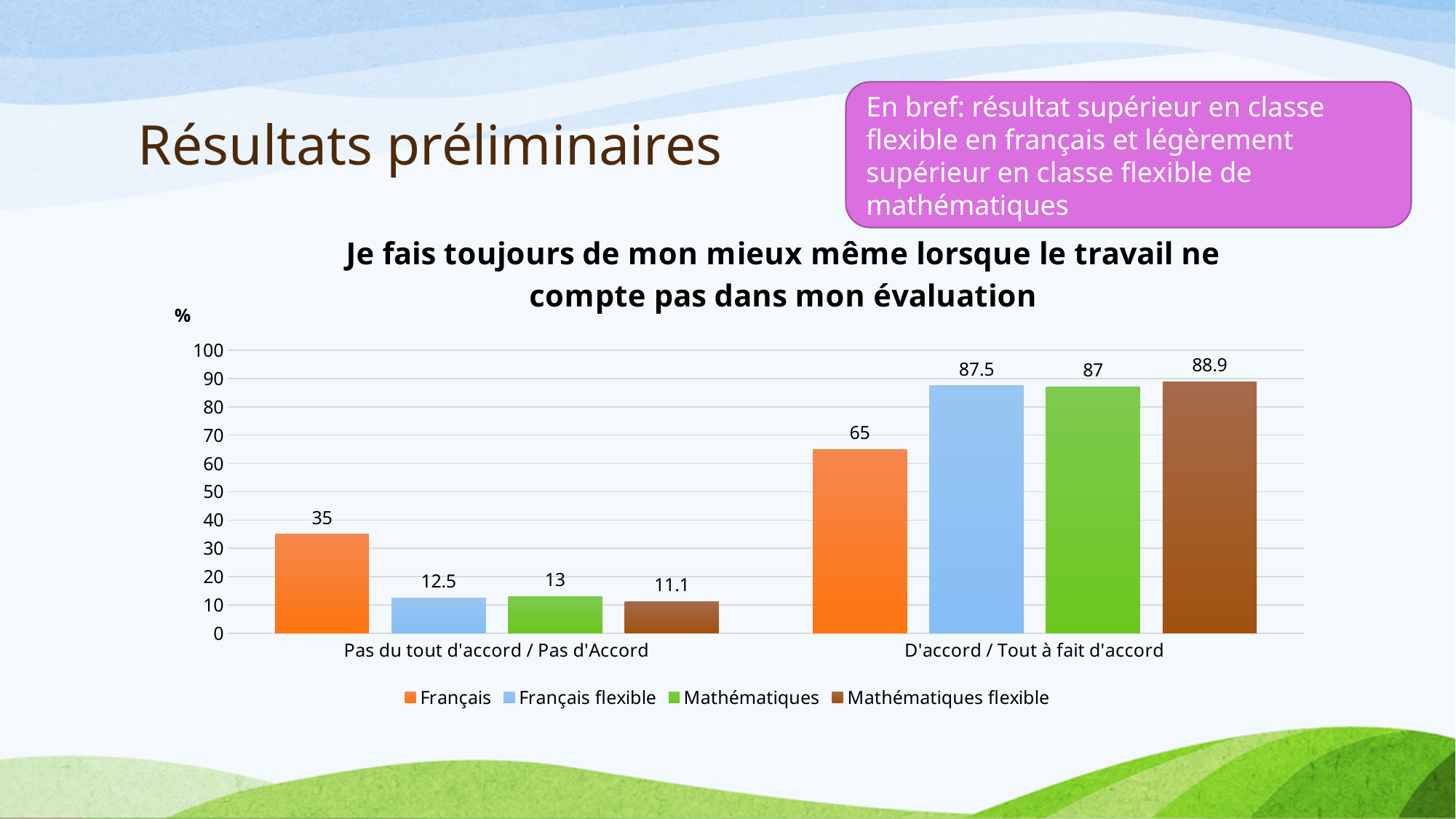
What is the value for Mathématiques flexible in the 'D'accord / Tout à fait d'accord' category? 88.9 Which series has the lowest value in the 'Pas du tout d'accord / Pas d'Accord' category? Mathématiques flexible Which series has the highest value in the 'D'accord / Tout à fait d'accord' category? Mathématiques flexible What is the difference between the Français flexible and Français values in the 'D'accord / Tout à fait d'accord' category? 22.5 In the 'Pas du tout d'accord / Pas d'Accord' category, which is larger: Français or Mathématiques? Français What kind of chart is shown on the slide? bar chart What is the value for Français flexible in the 'Pas du tout d'accord / Pas d'Accord' category? 12.5 What is the title of the chart? Je fais toujours de mon mieux même lorsque le travail ne compte pas dans mon évaluation What is the value for Français in the 'Pas du tout d'accord / Pas d'Accord' category? 35 Is the value for Français in the 'D'accord / Tout à fait d'accord' category greater or less than 70? less How many categories are shown on the x axis? 2 How many series does the legend list? 4